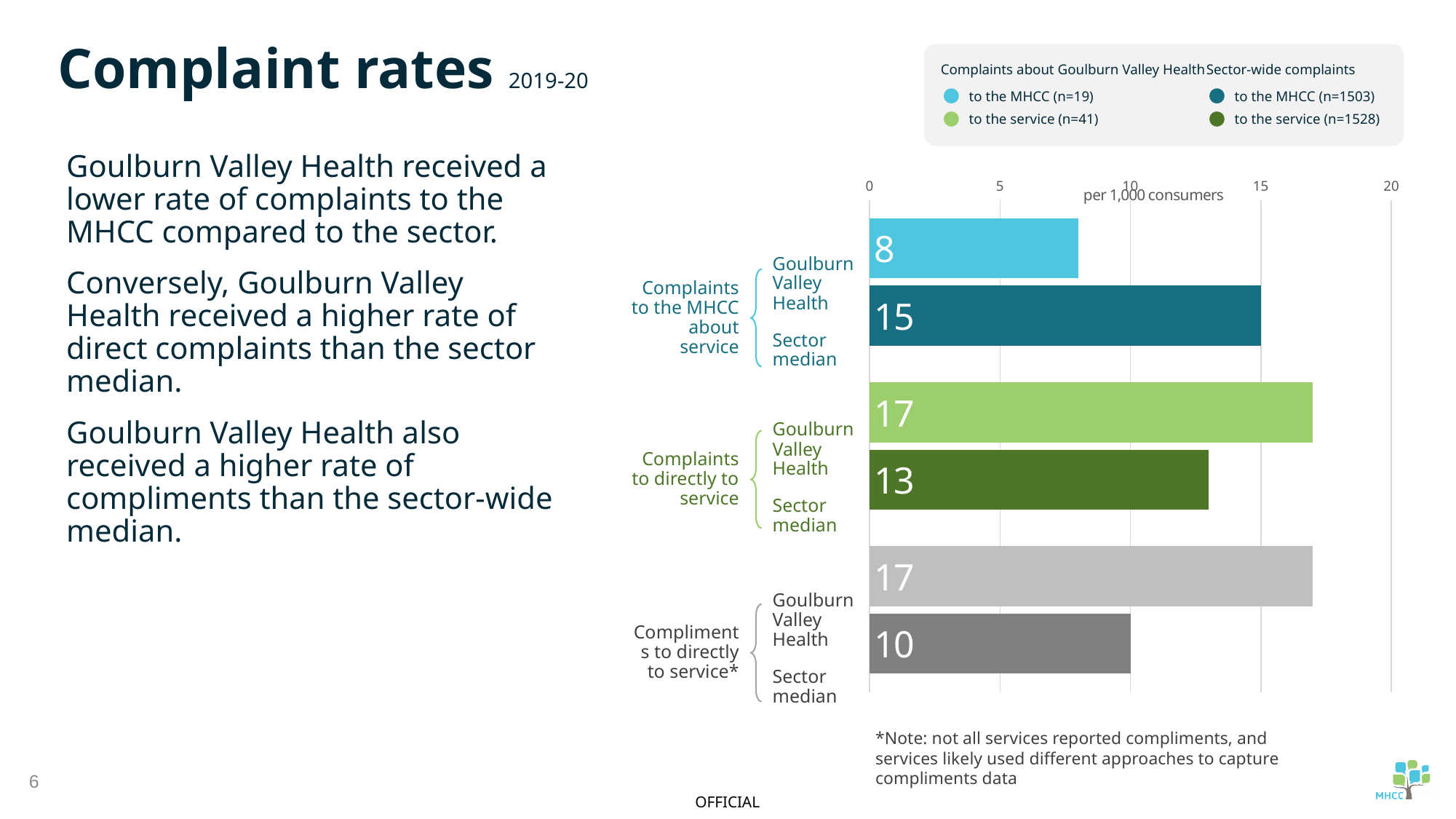
What is the rate of complaints made directly to the service for Goulburn Valley Health? 17 How many entries does the legend list? 4 How many bars are plotted on the chart? 6 What is the rate of complaints to the MHCC about service for Goulburn Valley Health? 8 Which is larger for compliments directly to service: Goulburn Valley Health or the sector median? Goulburn Valley Health What is the sector median rate of complaints to the MHCC about service? 15 What unit is shown on the chart's axis? per 1,000 consumers What is the difference between Goulburn Valley Health and the sector median for complaints made directly to the service? 4 What is the sector median rate of compliments made directly to the service? 10 What is the difference between the sector median and Goulburn Valley Health for complaints to the MHCC about service? 7 Which bar has the lowest value on the chart? Goulburn Valley Health, complaints to the MHCC about service What kind of chart is shown on the slide? Bar chart